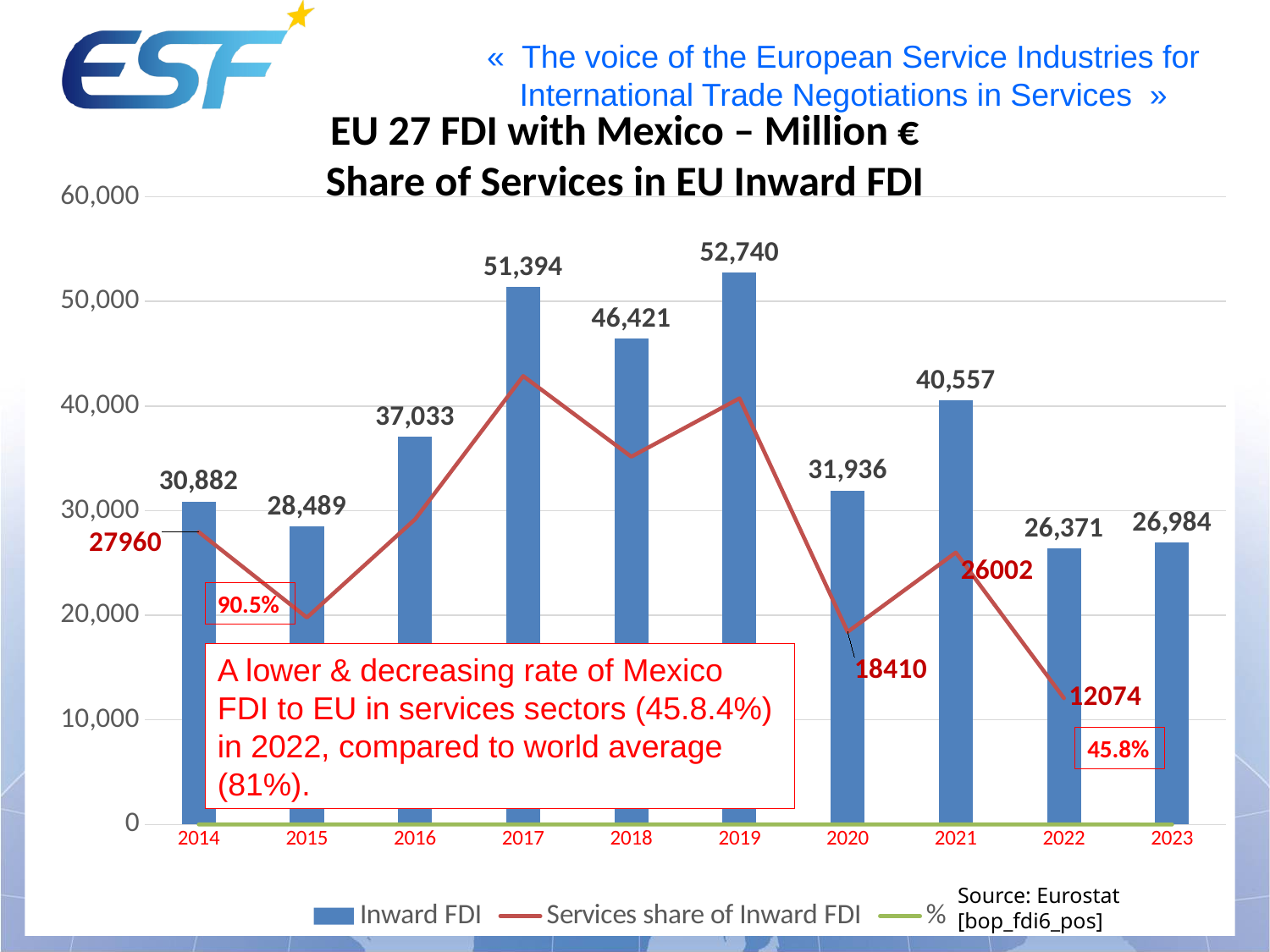
Which year has the larger Inward FDI value, 2016 or 2021? 2021 Do the Inward FDI values rise or fall from 2015 to 2017? rise How many years are shown on the x axis? 10 Which year has the lowest Inward FDI bar? 2022 What is the difference between the Inward FDI values for 2017 and 2018? 4,973 What kind of chart is shown on the slide? Bar chart with a line What is the Inward FDI value for 2019? 52,740 What is the labelled Services share of Inward FDI value for 2022? 12074 How many series does the legend list? 3 Is the Services share of Inward FDI line value for 2017 greater or less than 40,000? greater What source is cited for the chart data? Eurostat [bop_fdi6_pos] Which year has the highest Inward FDI bar? 2019